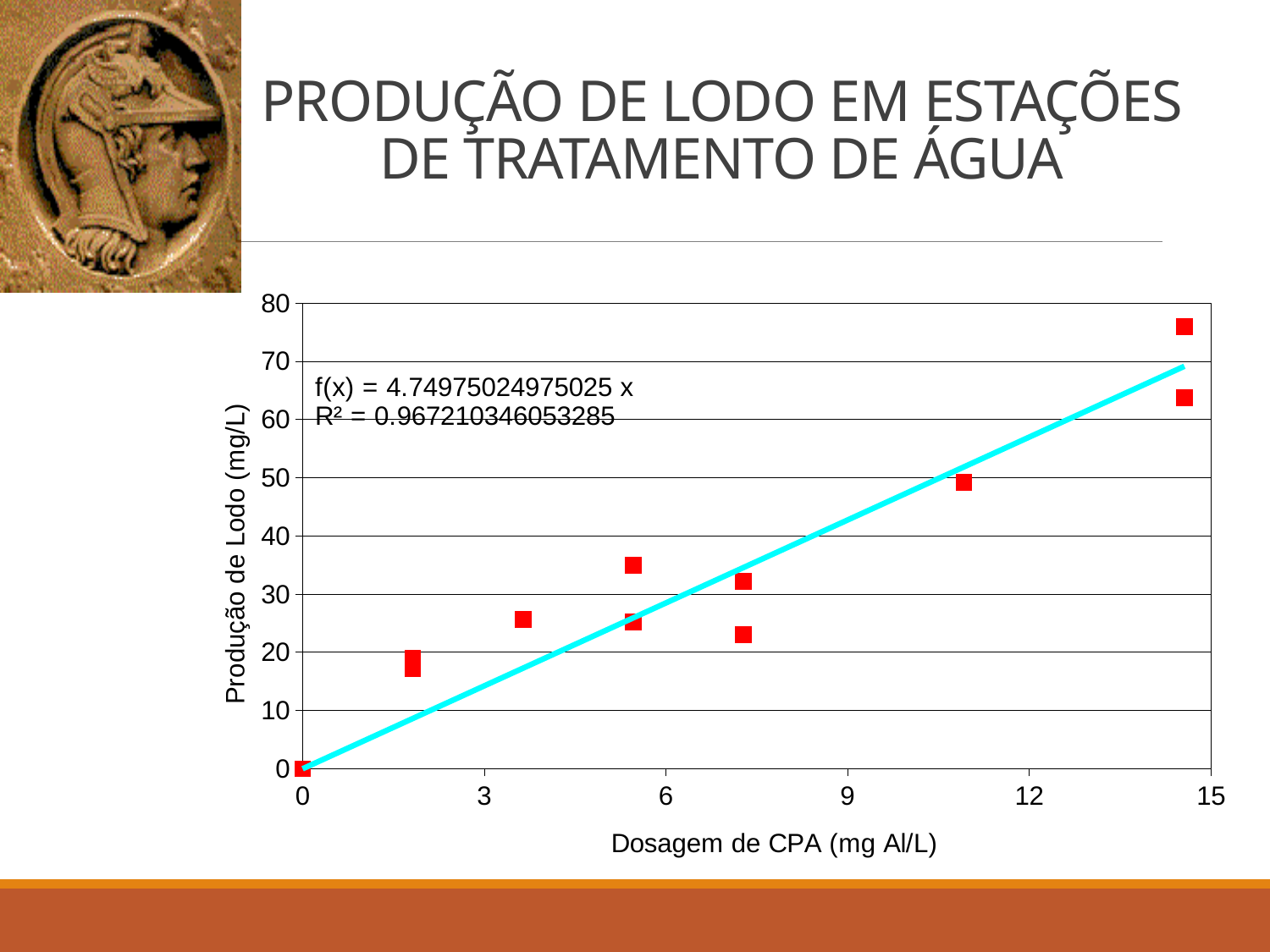
Which has the higher Produção de Lodo: the point at a dosage of about 11 mg Al/L or the point at about 3.6 mg Al/L? The point at about 11 mg Al/L Is the Produção de Lodo value for the point at a dosage of about 11 mg Al/L greater or less than 40? greater What is the maximum value shown on the x axis (Dosagem de CPA)? 15 Is the Produção de Lodo value for the point at a dosage of about 3.6 mg Al/L greater or less than 30? less What kind of chart is shown on the slide? Scatter chart What R² value is printed on the chart? 0.967210346053285 What is the maximum value shown on the y axis (Produção de Lodo)? 80 What is the trendline equation printed on the chart? f(x) = 4.74975024975025 x Is the highest plotted Produção de Lodo value greater or less than 70? greater Do the plotted values of Produção de Lodo generally rise or fall as Dosagem de CPA increases? Rise What is the lowest plotted Produção de Lodo value on the chart? 0